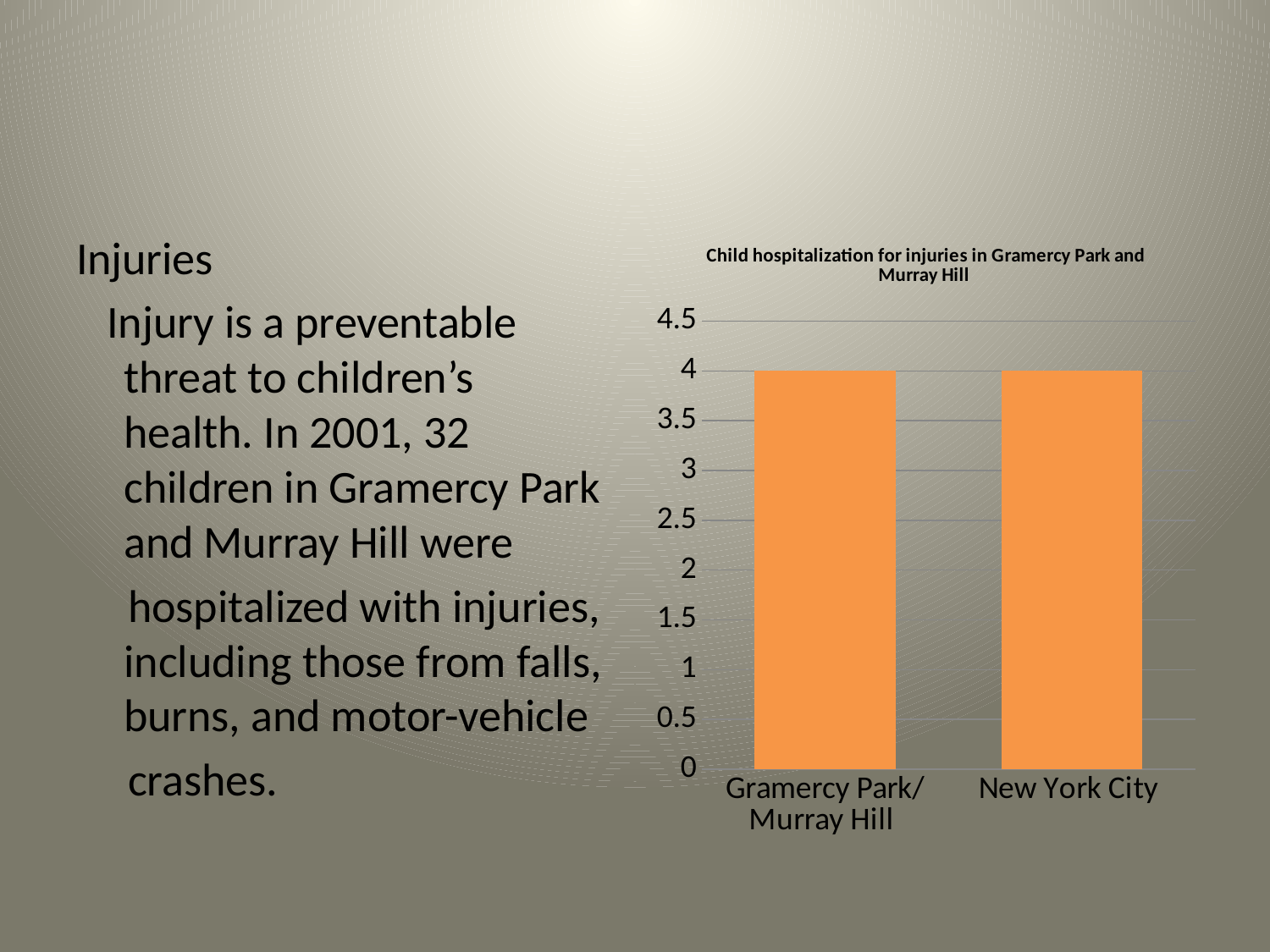
What is the difference between the values for Gramercy Park/Murray Hill and New York City? 0 Is the value for New York City greater or less than 4.5? less What is the value for New York City? 4 What type of chart is shown on the slide? bar chart What is the value for Gramercy Park/Murray Hill? 4 How many categories are plotted in the chart? 2 What is the title of the chart? Child hospitalization for injuries in Gramercy Park and Murray Hill What is the highest value shown on the vertical axis of the chart? 4.5 What colour are the bars in the chart? orange Is the value for Gramercy Park/Murray Hill greater or less than 3? greater